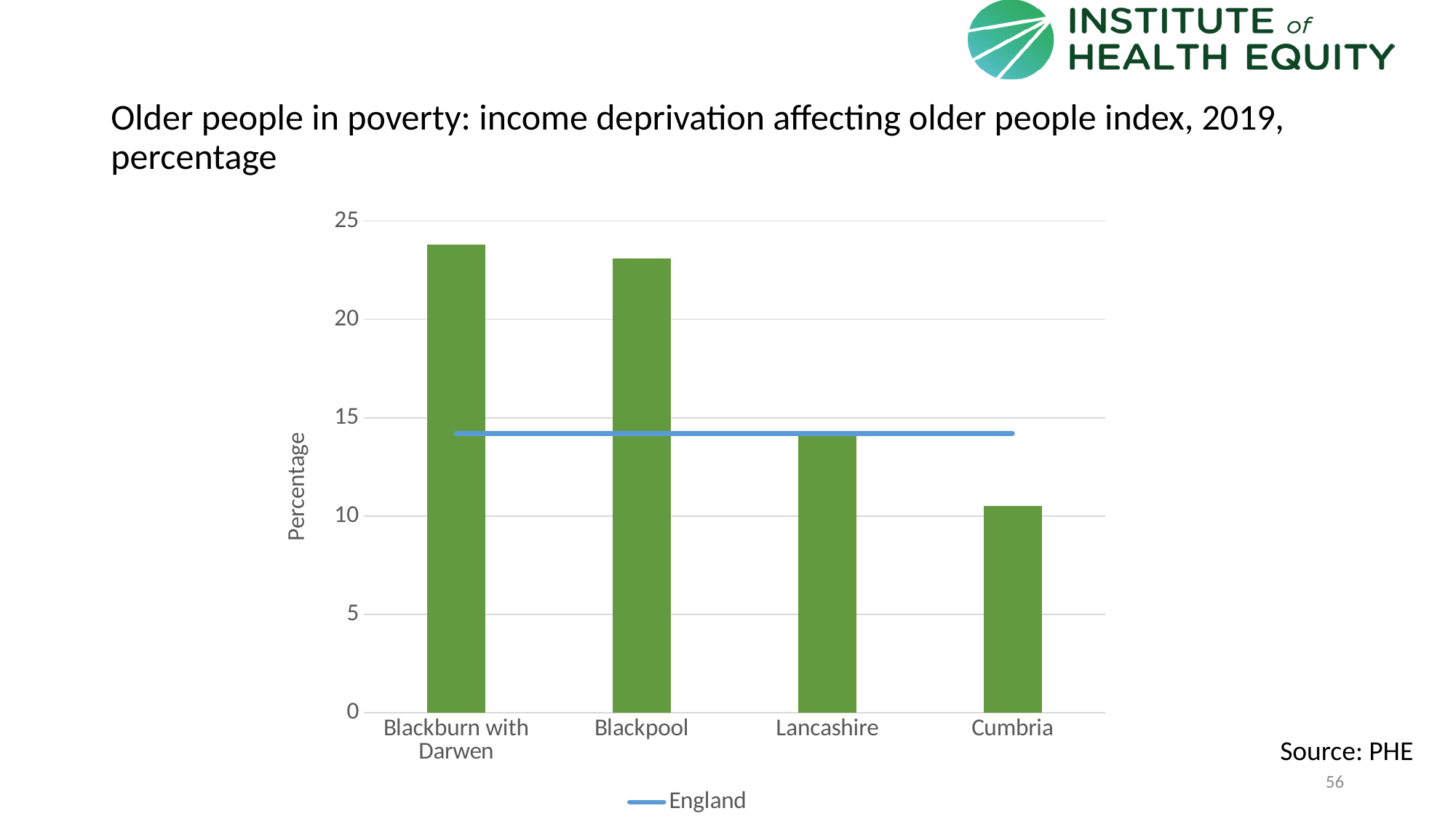
What does the blue horizontal line on the chart represent, according to the legend? England Which area has the highest bar? Blackburn with Darwen Do the bar values rise or fall from left to right across the chart? fall How many areas are shown as bars on the chart? 4 Is the value for Cumbria greater or less than 15? less Is the value for Blackburn with Darwen greater or less than 20? greater Which is larger, the value for Lancashire or the value for Blackburn with Darwen? Blackburn with Darwen Which area has the lowest bar? Cumbria Which is larger, the value for Blackpool or the value for Cumbria? Blackpool What kind of chart is shown on the slide? bar chart Is the value for Lancashire greater or less than 15? less How many entries does the legend list? 1